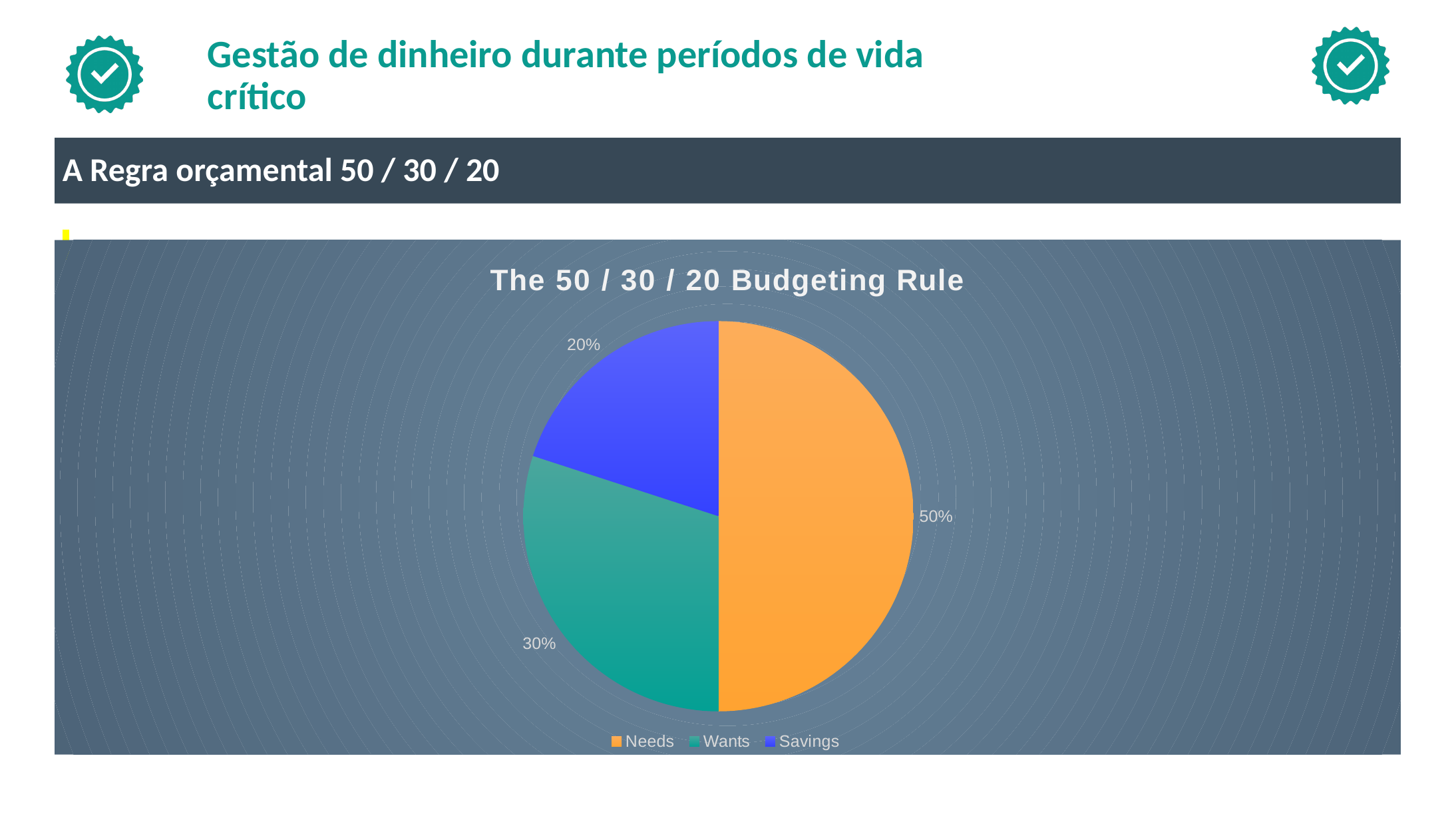
Which colour represents Savings in the legend? blue Which is larger, Wants or Savings? Wants What percentage of the pie is Wants? 30% What is the difference in percentage points between Wants and Savings? 10 What percentage of the pie is Needs? 50% How many slices does the pie chart have? 3 Which category has the largest slice of the pie? Needs What is the difference in percentage points between Needs and Savings? 30 What is the title of the chart? The 50 / 30 / 20 Budgeting Rule Which category has the smallest slice of the pie? Savings What type of chart is shown on the slide? pie chart What percentage of the pie is Savings? 20%